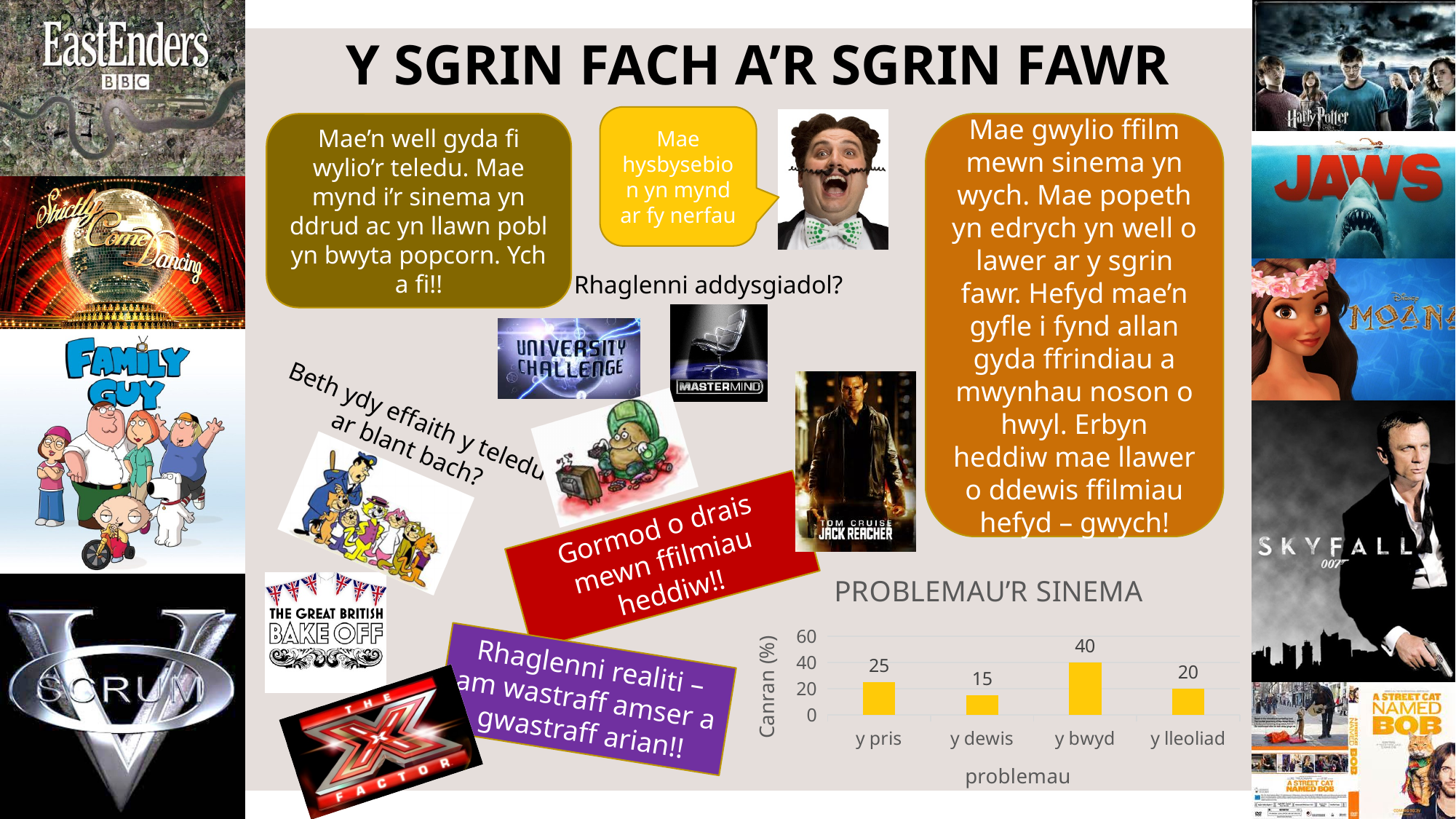
What is the label of the horizontal axis in the PROBLEMAU'R SINEMA chart? problemau What is the value for y lleoliad in the PROBLEMAU'R SINEMA chart? 20 What is the value for y dewis in the PROBLEMAU'R SINEMA chart? 15 Which category has the highest value in the PROBLEMAU'R SINEMA chart? y bwyd What is the value for y pris in the PROBLEMAU'R SINEMA chart? 25 What is the difference between the values for y bwyd and y pris in the PROBLEMAU'R SINEMA chart? 15 What is the value for y bwyd in the PROBLEMAU'R SINEMA chart? 40 What is the label of the vertical axis in the PROBLEMAU'R SINEMA chart? Canran (%) What kind of chart is the PROBLEMAU'R SINEMA chart? bar chart Which category has the lowest value in the PROBLEMAU'R SINEMA chart? y dewis How many categories are shown in the PROBLEMAU'R SINEMA chart? 4 Which is larger in the PROBLEMAU'R SINEMA chart, y pris or y lleoliad? y pris